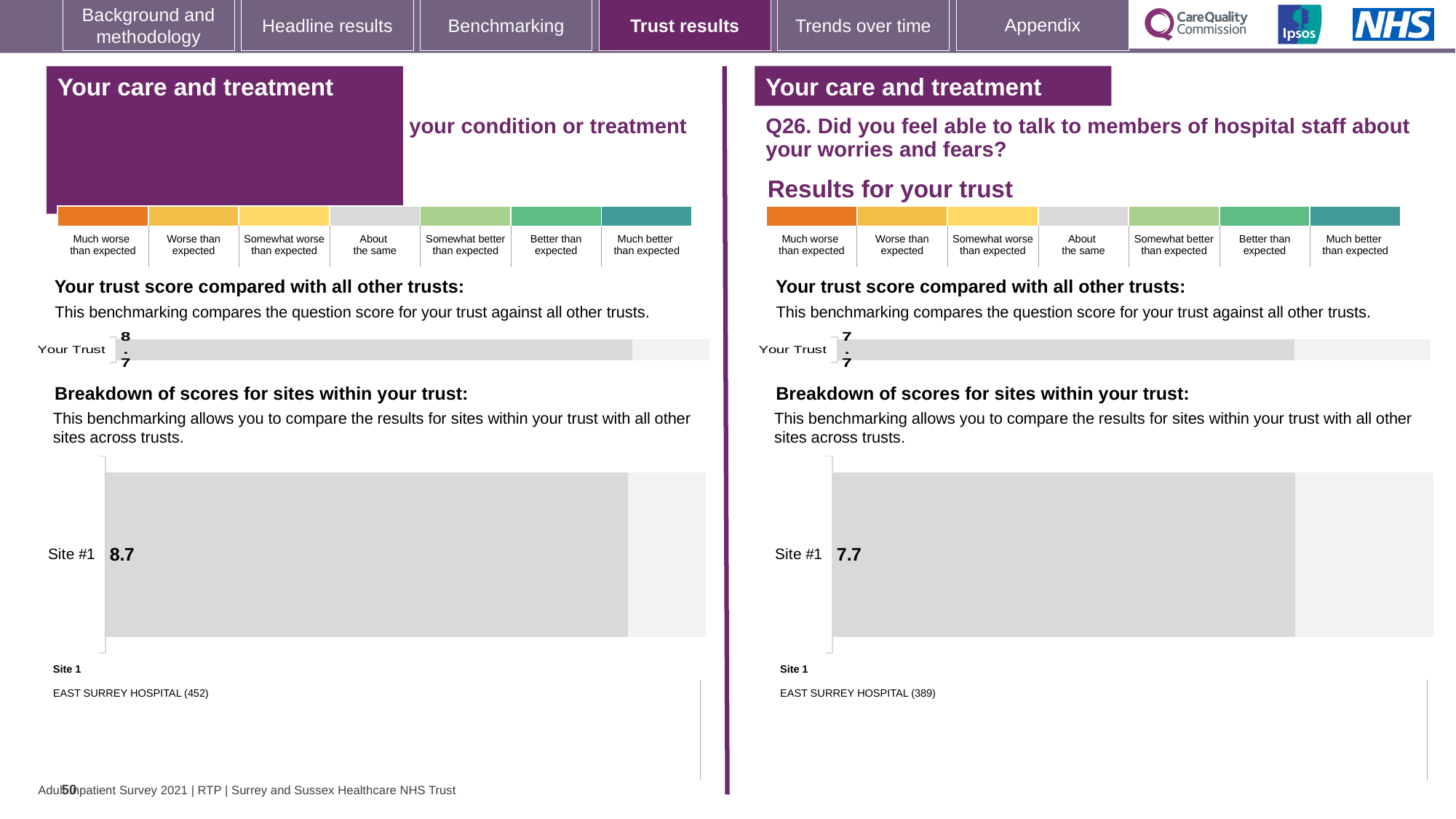
On the left panel, what is the score shown for Site #1 in the 'Breakdown of scores for sites within your trust' chart? 8.7 Which is larger: the Your Trust score on the left panel or the Your Trust score on the right panel (Q26)? Left panel (8.7) On the right panel (Q26), what is the score shown for Site #1 in the 'Breakdown of scores for sites within your trust' chart? 7.7 What kind of chart is used to show the Site #1 score on the right panel (Q26)? Bar chart On the right panel (Q26), which hospital is listed as Site 1 below the site breakdown chart? EAST SURREY HOSPITAL (389) On the left panel, which hospital is listed as Site 1 below the site breakdown chart? EAST SURREY HOSPITAL (452) How many sites are shown in the 'Breakdown of scores for sites within your trust' chart on the left panel? 1 What is the difference between the Site #1 score on the left panel and the Site #1 score on the right panel (Q26)? 1.0 How many sites are shown in the 'Breakdown of scores for sites within your trust' chart on the right panel (Q26)? 1 On the right panel (Q26), is the Site #1 score greater or less than the Your Trust score, or are they equal? Equal On the right panel (Q26), what is the score shown for Your Trust in the 'Your trust score compared with all other trusts' chart? 7.7 On the left panel, what is the score shown for Your Trust in the 'Your trust score compared with all other trusts' chart? 8.7